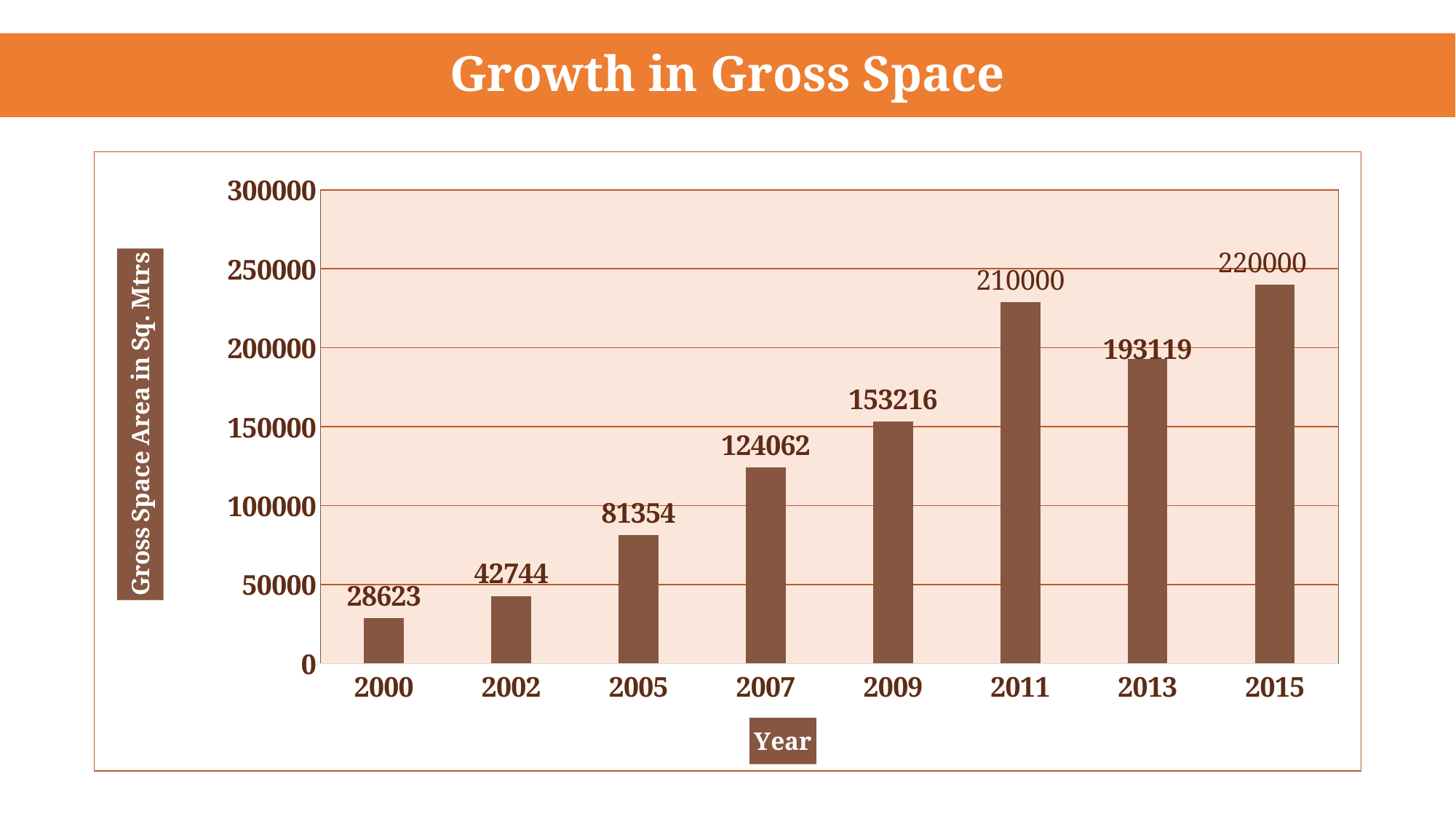
Which year has the lowest gross space area? 2000 How many years are shown on the x axis? 8 What is the difference in gross space area between 2007 and 2005? 42708 Which year has the highest gross space area? 2015 What is the gross space area for 2000? 28623 What is the gross space area for 2009? 153216 What is the difference in gross space area between 2015 and 2011? 10000 What is the title of the chart? Growth in Gross Space What is the gross space area for 2013? 193119 Is the value for 2009 greater or less than 150000? greater What kind of chart is shown on the slide? Bar chart Which year has a larger gross space area, 2011 or 2013? 2011